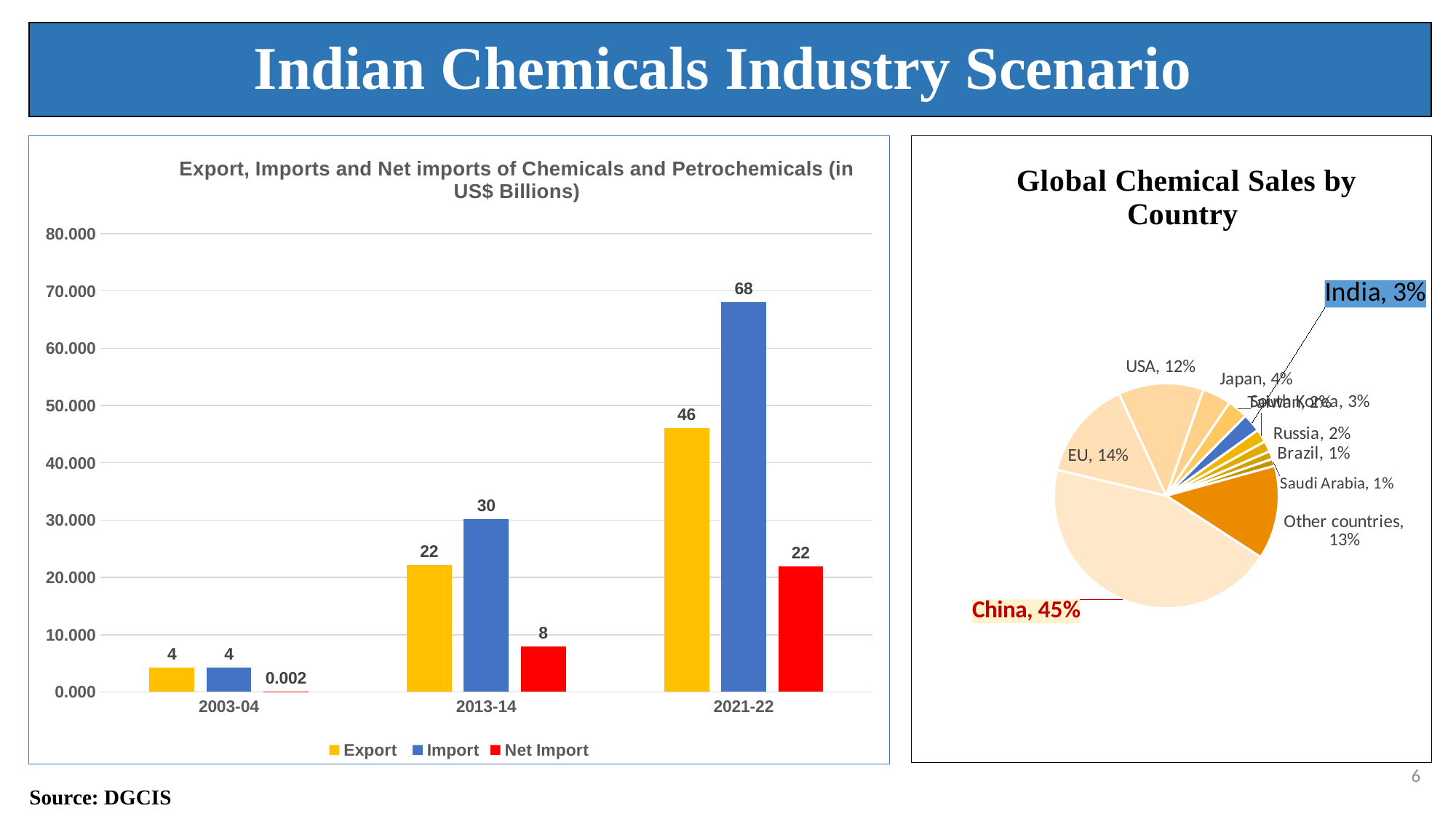
In the left chart, what is the Export value for 2013-14? 22 In the left chart, what is the Net Import value for 2003-04? 0.002 In the left chart, which year has the highest Import value? 2021-22 In the left chart, what is the difference between Import and Export in 2021-22? 22 In the left chart, what is the Import value for 2021-22? 68 In the left chart, how many series does the legend list? 3 In the 'Global Chemical Sales by Country' chart, what share does China have? 45% What type of chart is the 'Global Chemical Sales by Country' chart? pie chart In the 'Global Chemical Sales by Country' chart, which country has the largest share? China In the 'Global Chemical Sales by Country' chart, which is larger, the share for EU or the share for USA? EU In the left chart, is the Export value for 2021-22 greater or less than 40.000? greater In the left chart, does the Net Import value rise or fall from 2003-04 to 2021-22? rise